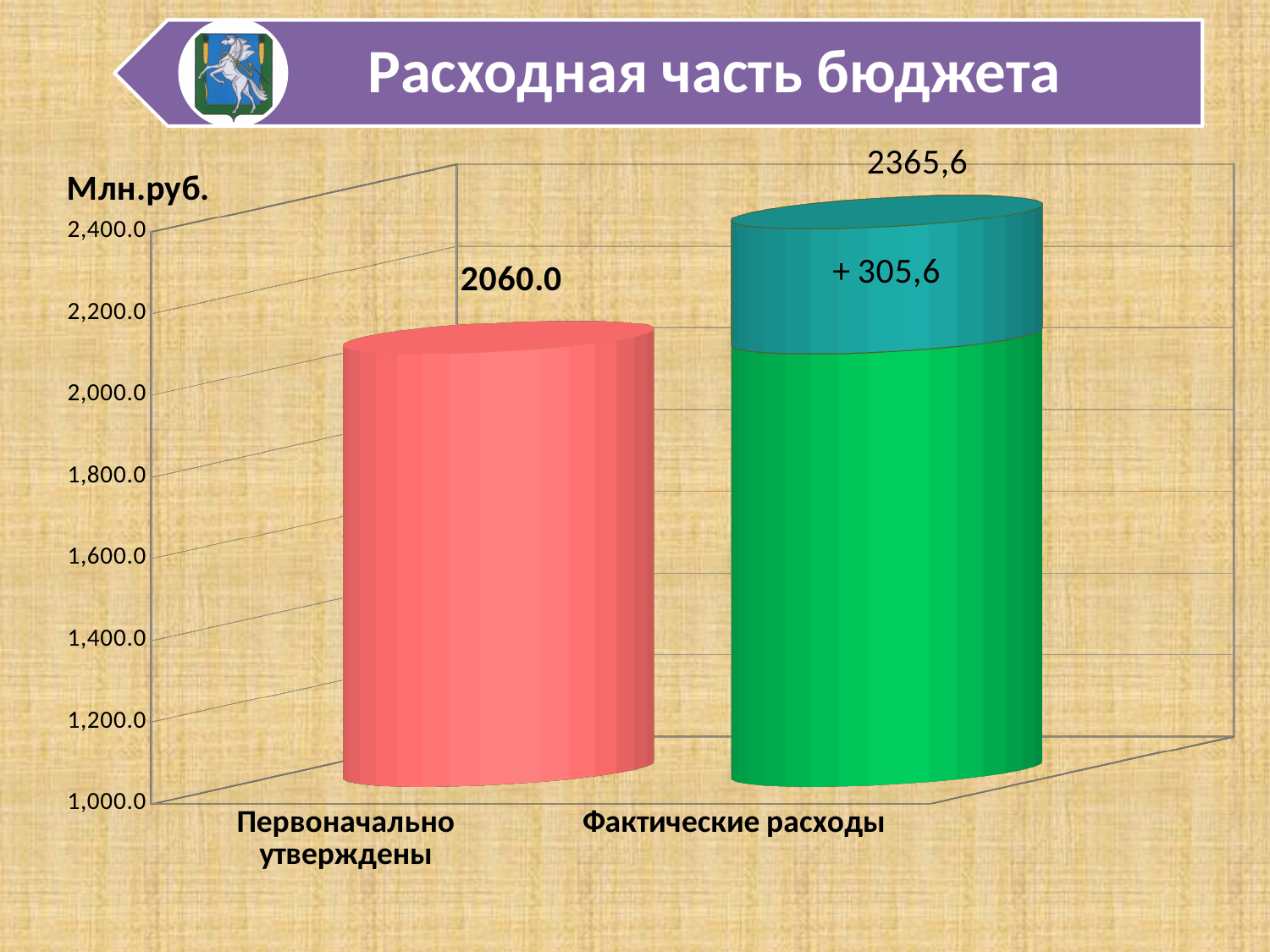
What is the title of the slide? Расходная часть бюджета By how much do Фактические расходы exceed Первоначально утверждены? 305,6 Which is larger: Первоначально утверждены or Фактические расходы? Фактические расходы What unit is shown on the vertical axis? Млн.руб. Is the value for Фактические расходы greater or less than 2,200.0? greater What is the value for Первоначально утверждены? 2060.0 How many categories are shown on the chart? 2 Which category has the lowest value? Первоначально утверждены Which category has the highest value? Фактические расходы What kind of chart is shown on the slide? Bar chart Is the value for Первоначально утверждены greater or less than 2,200.0? less What is the value for Фактические расходы? 2365,6